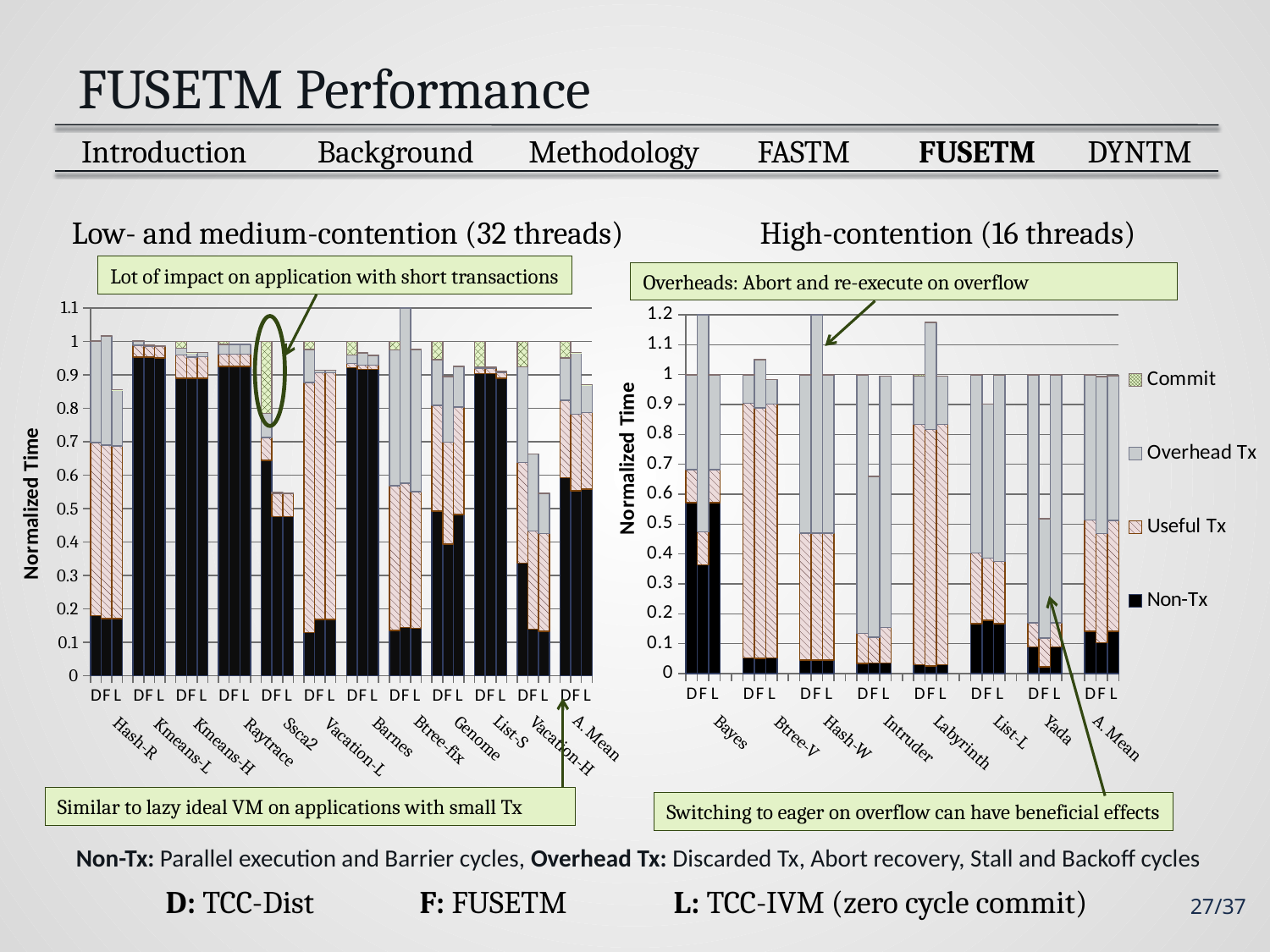
In the 'Low- and medium-contention (32 threads)' chart, is the total height of the F bar for Btree-fix greater or less than 1.1? greater What kind of chart is the 'Low- and medium-contention (32 threads)' chart? Stacked bar chart In the 'Low- and medium-contention (32 threads)' chart, is the total height of the F bar for Ssca2 greater or less than 0.7? less In the 'High-contention (16 threads)' chart, which is taller: the F bar for Bayes or the D bar for Intruder? The F bar for Bayes In the 'High-contention (16 threads)' chart, is the total height of the F bar for Labyrinth greater or less than 1.1? greater What is the y-axis label of the 'High-contention (16 threads)' chart? Normalized Time In the 'Low- and medium-contention (32 threads)' chart, which is taller: the D bar for Kmeans-L or the F bar for Ssca2? The D bar for Kmeans-L How many application categories are shown on the x axis of the 'Low- and medium-contention (32 threads)' chart? 12 Which legend entry in the 'High-contention (16 threads)' chart is shown in solid black? Non-Tx How many series does the legend of the 'High-contention (16 threads)' chart list? 4 How many application categories are shown on the x axis of the 'High-contention (16 threads)' chart? 8